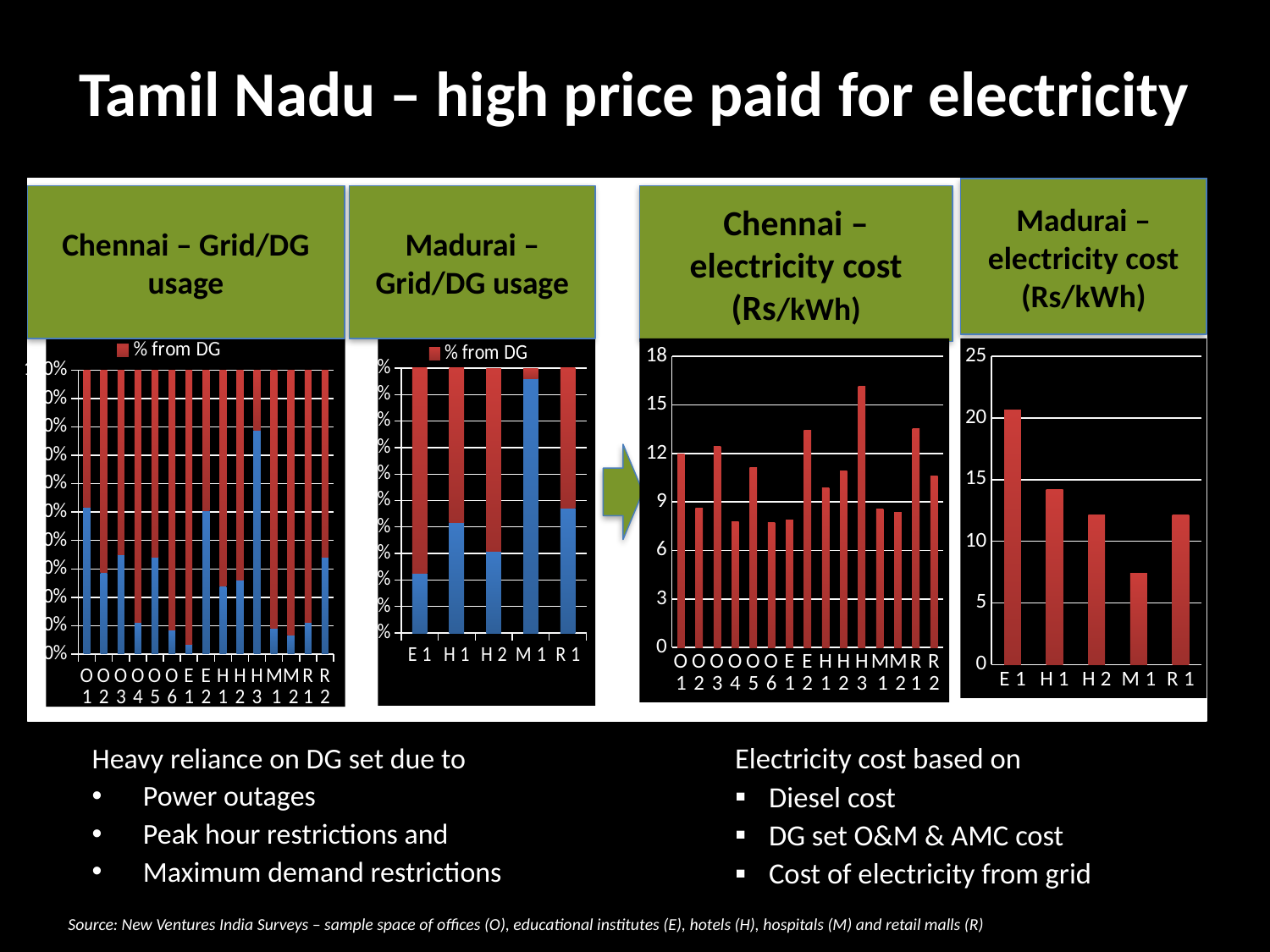
In the 'Chennai – electricity cost (Rs/kWh)' chart, is the value for H 3 greater or less than 15? greater How many categories are plotted in the 'Chennai – electricity cost (Rs/kWh)' chart? 15 In the 'Chennai – electricity cost (Rs/kWh)' chart, which is larger, the value for E 2 or the value for E 1? E 2 In the 'Madurai – Grid/DG usage' chart, which category has the smallest share from DG? M 1 In the 'Chennai – electricity cost (Rs/kWh)' chart, which category has the highest electricity cost? H 3 In the 'Madurai – electricity cost (Rs/kWh)' chart, which category has the highest electricity cost? E 1 In the 'Chennai – electricity cost (Rs/kWh)' chart, is the value for O 2 greater or less than 9? less What series name is shown in the legend of the 'Chennai – Grid/DG usage' chart? % from DG How many charts are shown on the slide? 4 In the 'Madurai – electricity cost (Rs/kWh)' chart, is the value for M 1 greater or less than 10? less In the 'Madurai – electricity cost (Rs/kWh)' chart, which category has the lowest electricity cost? M 1 What kind of chart is the 'Chennai – electricity cost (Rs/kWh)' chart? bar chart